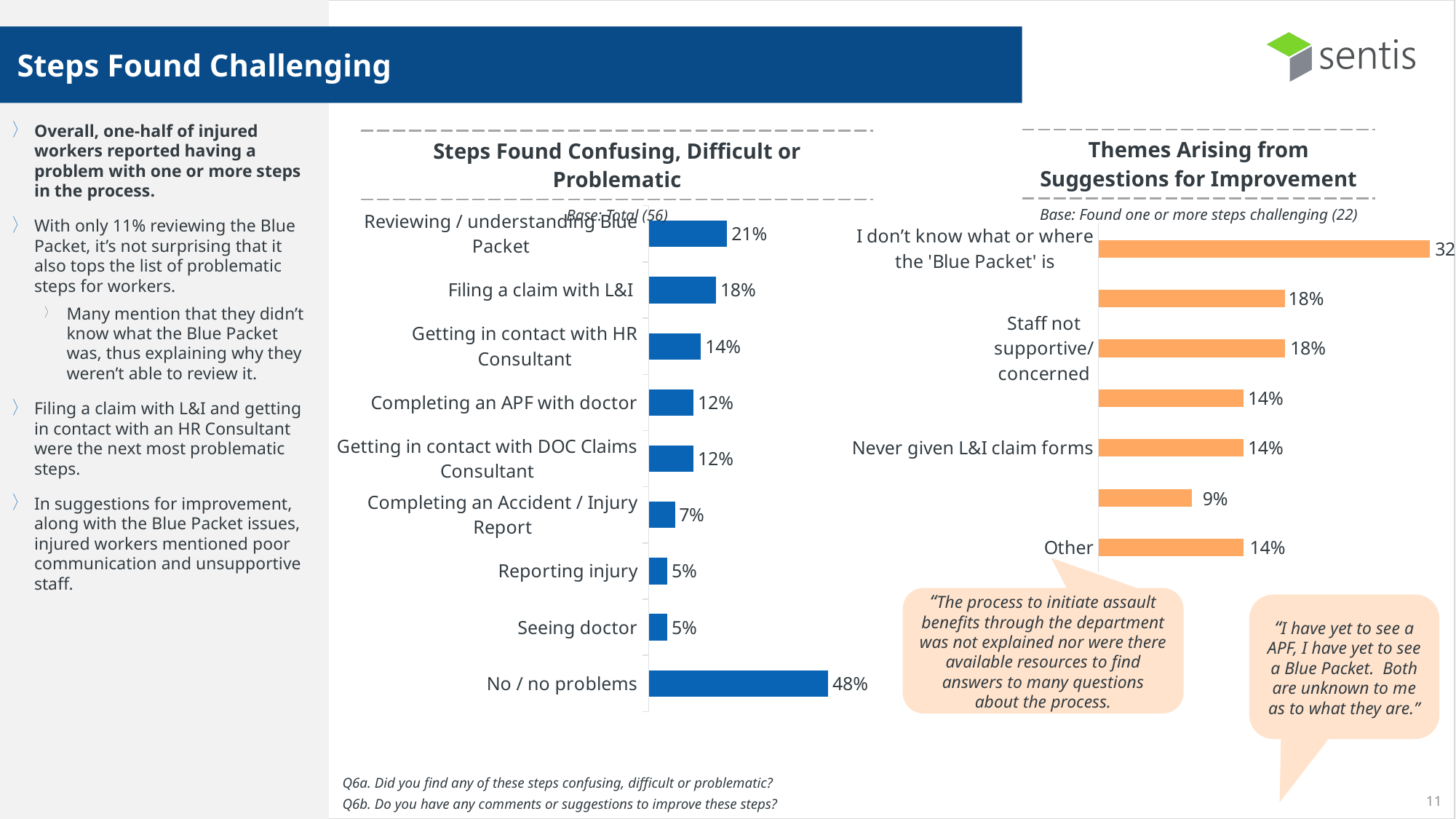
In the 'Steps Found Confusing, Difficult or Problematic' chart, what percentage is shown for 'No / no problems'? 48% How many bars are plotted in the 'Themes Arising from Suggestions for Improvement' chart? 7 In the 'Themes Arising from Suggestions for Improvement' chart, what percentage is shown for 'Staff not supportive/concerned'? 18% How many categories are plotted in the 'Steps Found Confusing, Difficult or Problematic' chart? 9 In the 'Steps Found Confusing, Difficult or Problematic' chart, what percentage is shown for 'Filing a claim with L&I'? 18% In the 'Themes Arising from Suggestions for Improvement' chart, which theme has the longest bar? I don't know what or where the 'Blue Packet' is In the 'Steps Found Confusing, Difficult or Problematic' chart, what percentage is shown for 'Completing an Accident / Injury Report'? 7% What type of chart is the 'Steps Found Confusing, Difficult or Problematic' chart? Bar chart In the 'Steps Found Confusing, Difficult or Problematic' chart, which category has the highest value? No / no problems In the 'Steps Found Confusing, Difficult or Problematic' chart, what is the difference between 'Reviewing / understanding Blue Packet' and 'Getting in contact with HR Consultant'? 7% In the 'Themes Arising from Suggestions for Improvement' chart, what percentage is shown for 'Never given L&I claim forms'? 14% In the 'Steps Found Confusing, Difficult or Problematic' chart, which is larger: 'Filing a claim with L&I' or 'Completing an APF with doctor'? Filing a claim with L&I